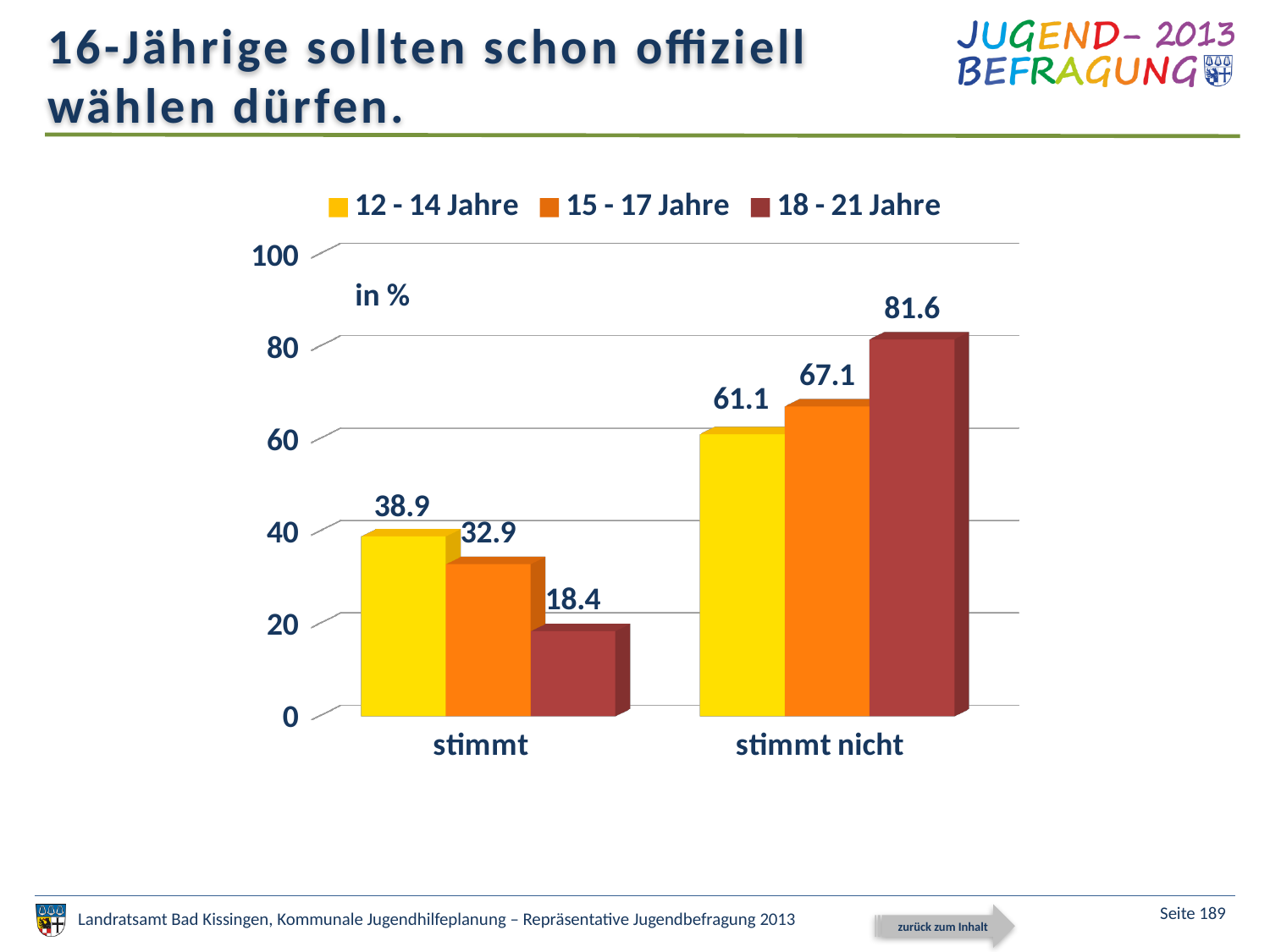
How many series does the legend list? 3 What is the value for the 18 - 21 Jahre series in the "stimmt nicht" category? 81.6 Is the value for 15 - 17 Jahre in the "stimmt nicht" category greater or less than 60? greater What is the difference between the 18 - 21 Jahre value and the 12 - 14 Jahre value in the "stimmt nicht" category? 20.5 What unit is indicated on the chart? in % Which is larger: the 12 - 14 Jahre value for "stimmt" or the 15 - 17 Jahre value for "stimmt"? 12 - 14 Jahre How many categories are shown on the x axis? 2 What is the value for the 15 - 17 Jahre series in the "stimmt" category? 32.9 What kind of chart is shown on the slide? bar chart Which age group has the highest value in the "stimmt nicht" category? 18 - 21 Jahre What is the value for the 12 - 14 Jahre series in the "stimmt" category? 38.9 Which age group has the lowest value in the "stimmt" category? 18 - 21 Jahre